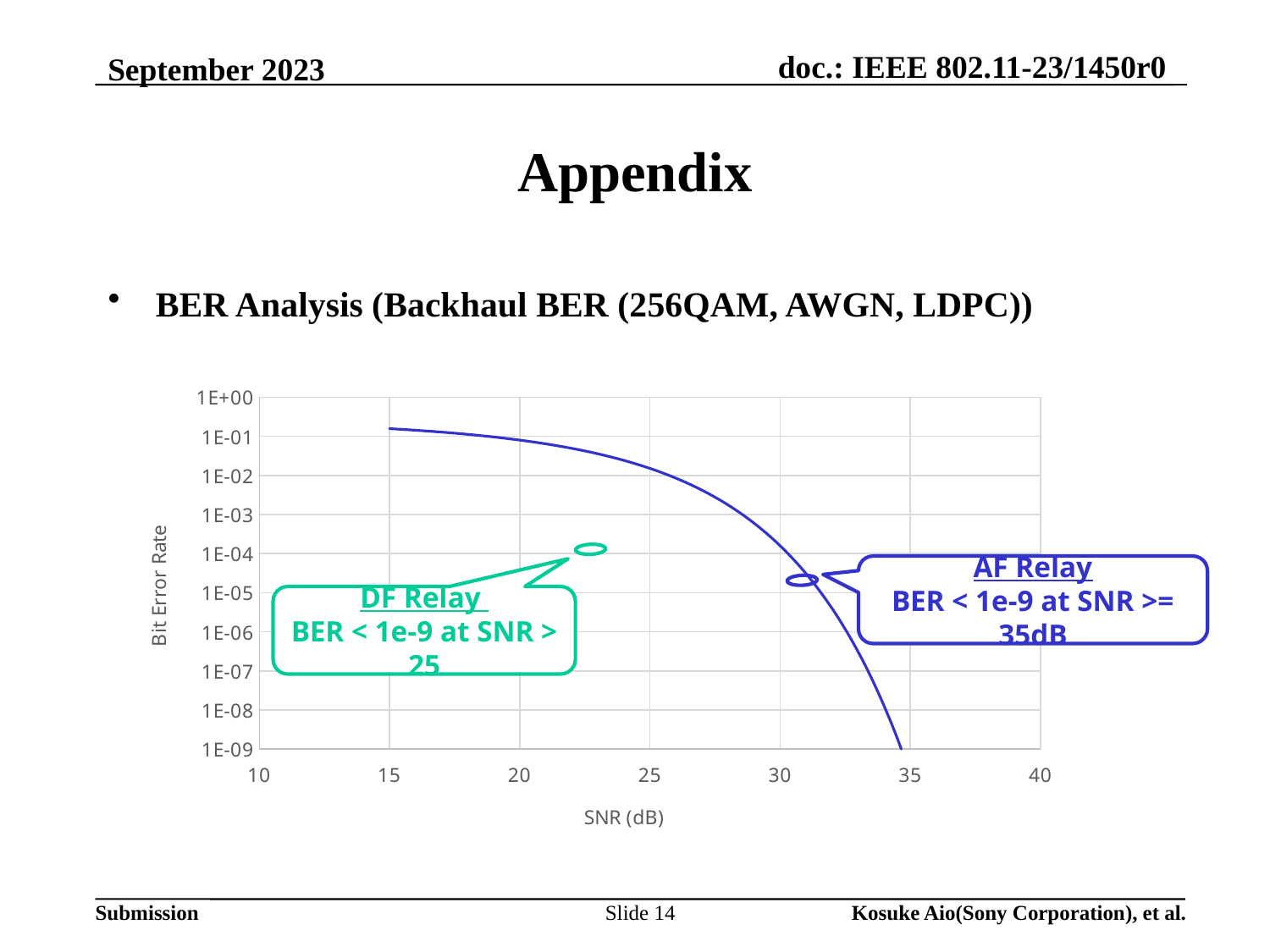
Is the Bit Error Rate at SNR 30 dB greater or less than 1E-03? less Does the Bit Error Rate rise or fall as SNR (dB) increases along the x axis? fall How many lines are plotted on the chart? 1 What is the label of the y axis of the chart? Bit Error Rate What kind of chart is shown on the slide? line chart Which has the larger Bit Error Rate: SNR 15 dB or SNR 25 dB? SNR 15 dB Is the Bit Error Rate at SNR 25 dB greater or less than 1E-01? less Is the Bit Error Rate at SNR 15 dB greater or less than 1E-02? greater What is the label of the x axis of the chart? SNR (dB) Which has the larger Bit Error Rate: SNR 20 dB or SNR 30 dB? SNR 20 dB